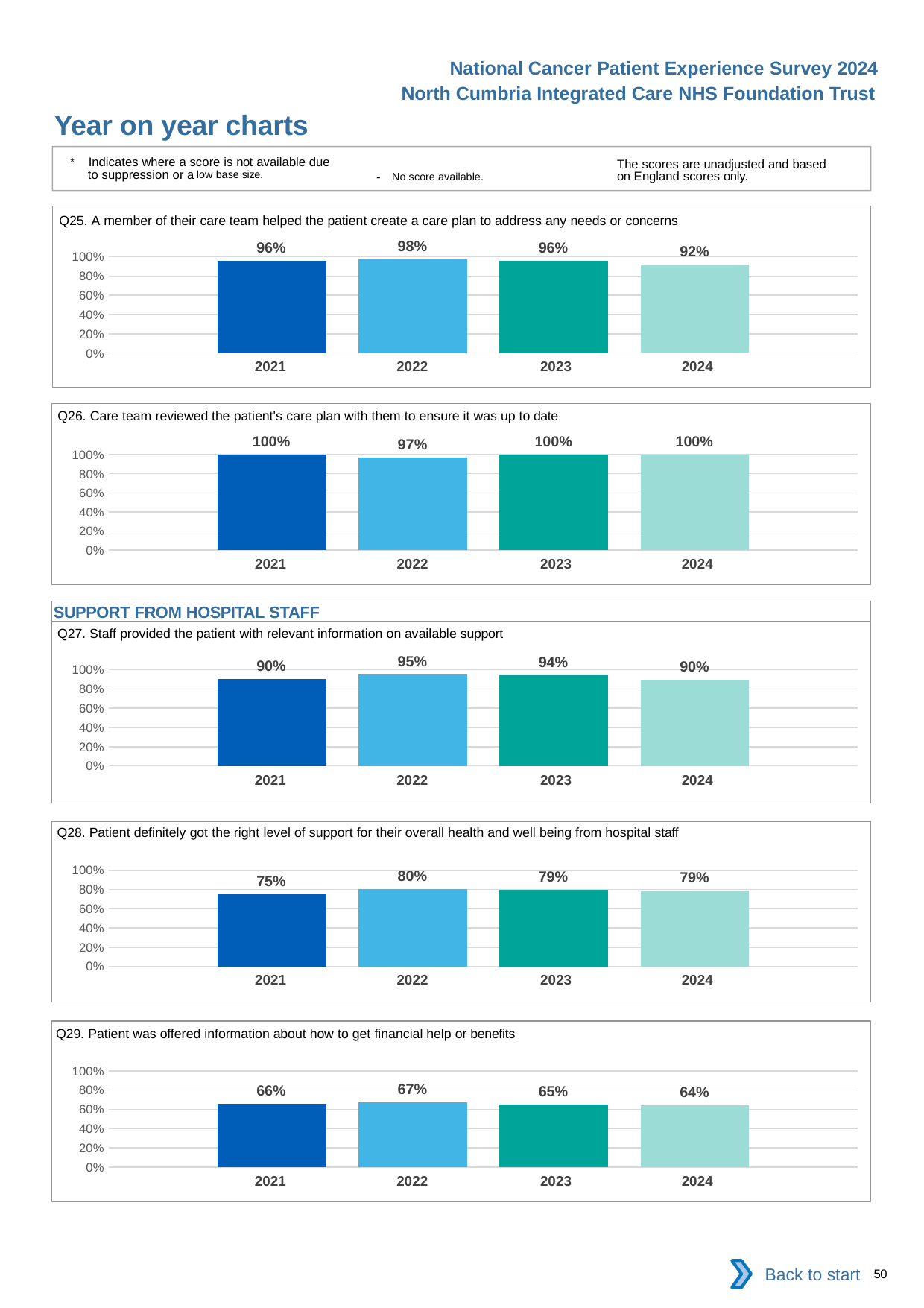
In the Q28 chart, is the value for 2021 greater or less than 80%? less In the Q28 chart, what is the value for 2021? 75% In the Q27 chart, what is the difference between the 2022 and 2024 values? 5% In the Q29 chart, what is the difference between the 2022 and 2023 values? 2% In the Q29 chart, what is the value for 2024? 64% In the Q25 chart, what is the value for 2022? 98% In the Q26 chart, what is the value for 2022? 97% In the Q25 chart, which year has the lowest value? 2024 In the Q28 chart, which is larger, the value for 2021 or the value for 2022? 2022 In the Q27 chart, which year has the highest value? 2022 What kind of chart is the Q29 chart? Bar chart In the Q26 chart, how many years are plotted? 4